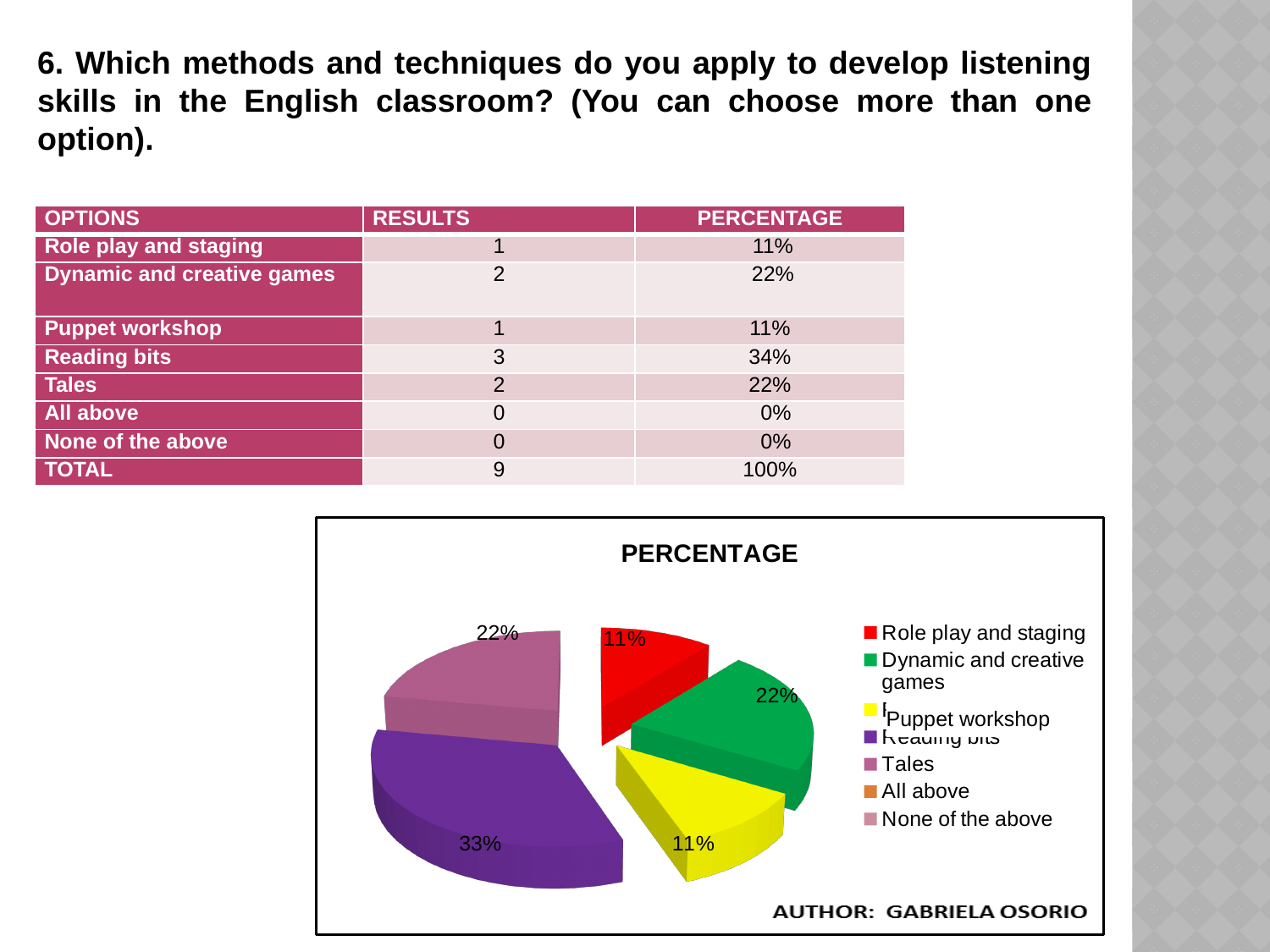
Which is larger in the chart, the slice for Dynamic and creative games or the slice for Puppet workshop? Dynamic and creative games How many entries does the chart's legend list? 7 What percentage does the chart show for Reading bits? 33% What percentage does the chart show for Dynamic and creative games? 22% What percentage does the chart show for Puppet workshop? 11% What percentage does the chart show for Role play and staging? 11% What is the difference between the chart's percentage for Reading bits and its percentage for Tales? 11% What is the title of the chart? PERCENTAGE What percentage does the chart show for Tales? 22% What kind of chart is shown on the slide? pie chart Which colour represents Reading bits in the chart? purple Which category has the largest slice of the pie? Reading bits